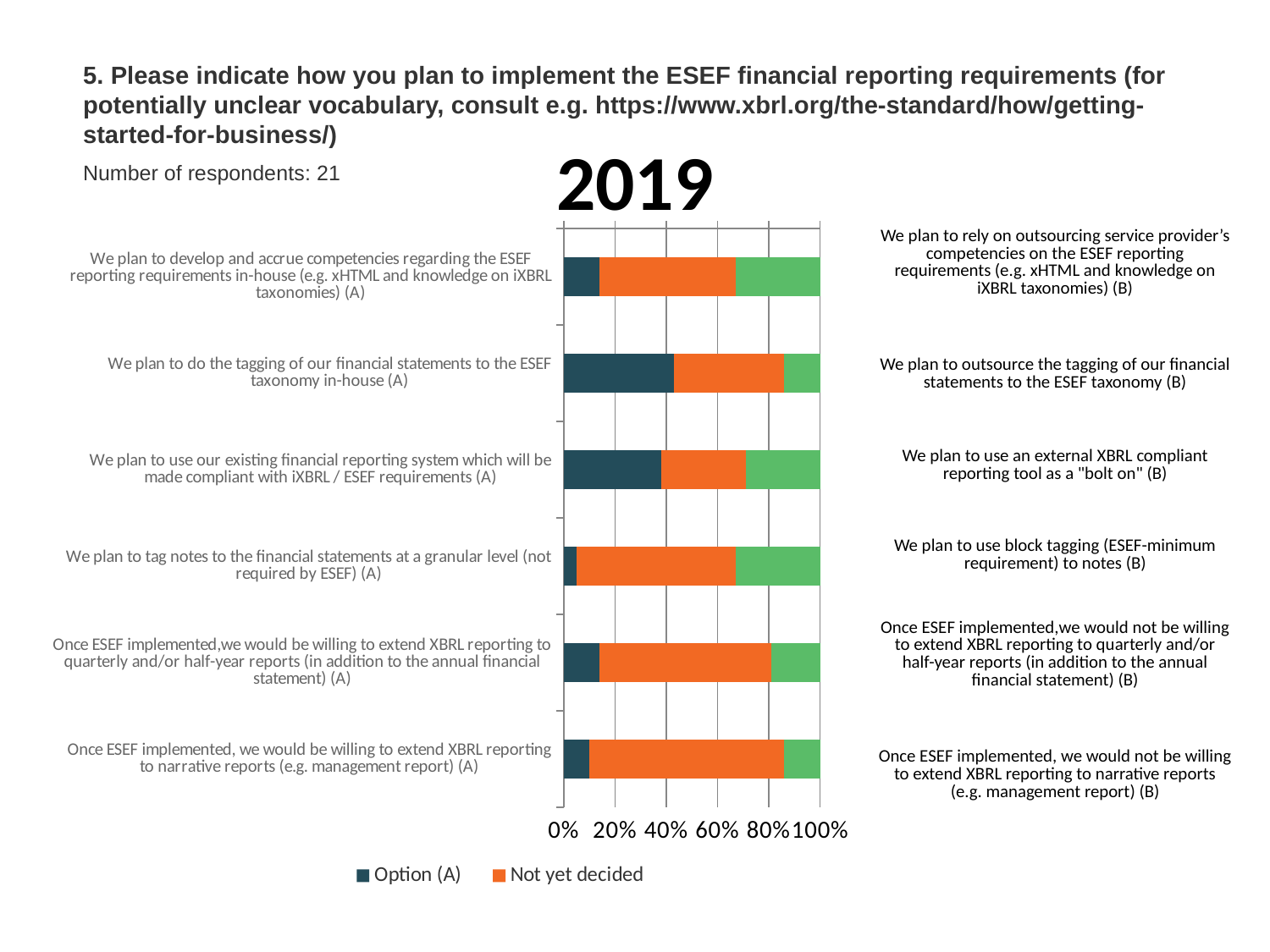
What kind of chart is shown on the slide? Stacked bar chart What is the title of the chart? 2019 Which has the larger Option (A) share: 'We plan to use our existing financial reporting system which will be made compliant with iXBRL / ESEF requirements (A)' or 'We plan to tag notes to the financial statements at a granular level (A)'? We plan to use our existing financial reporting system which will be made compliant with iXBRL / ESEF requirements (A) How many categories (rows) does the chart show? 6 Which category has the smallest Option (A) share? We plan to tag notes to the financial statements at a granular level (not required by ESEF) (A) Which series is shown in dark blue according to the legend? Option (A) Which has the larger Option (A) share: 'We plan to do the tagging of our financial statements to the ESEF taxonomy in-house (A)' or 'Once ESEF implemented, we would be willing to extend XBRL reporting to narrative reports (A)'? We plan to do the tagging of our financial statements to the ESEF taxonomy in-house (A) Is the Option (A) share for 'We plan to develop and accrue competencies regarding the ESEF reporting requirements in-house' greater or less than 20%? less Is the Option (A) share for 'We plan to use our existing financial reporting system which will be made compliant with iXBRL / ESEF requirements (A)' greater or less than 20%? greater Is the Option (A) share for 'We plan to do the tagging of our financial statements to the ESEF taxonomy in-house (A)' greater or less than 20%? greater Which category has the largest Option (A) share? We plan to do the tagging of our financial statements to the ESEF taxonomy in-house (A) How many series does the legend list? 2